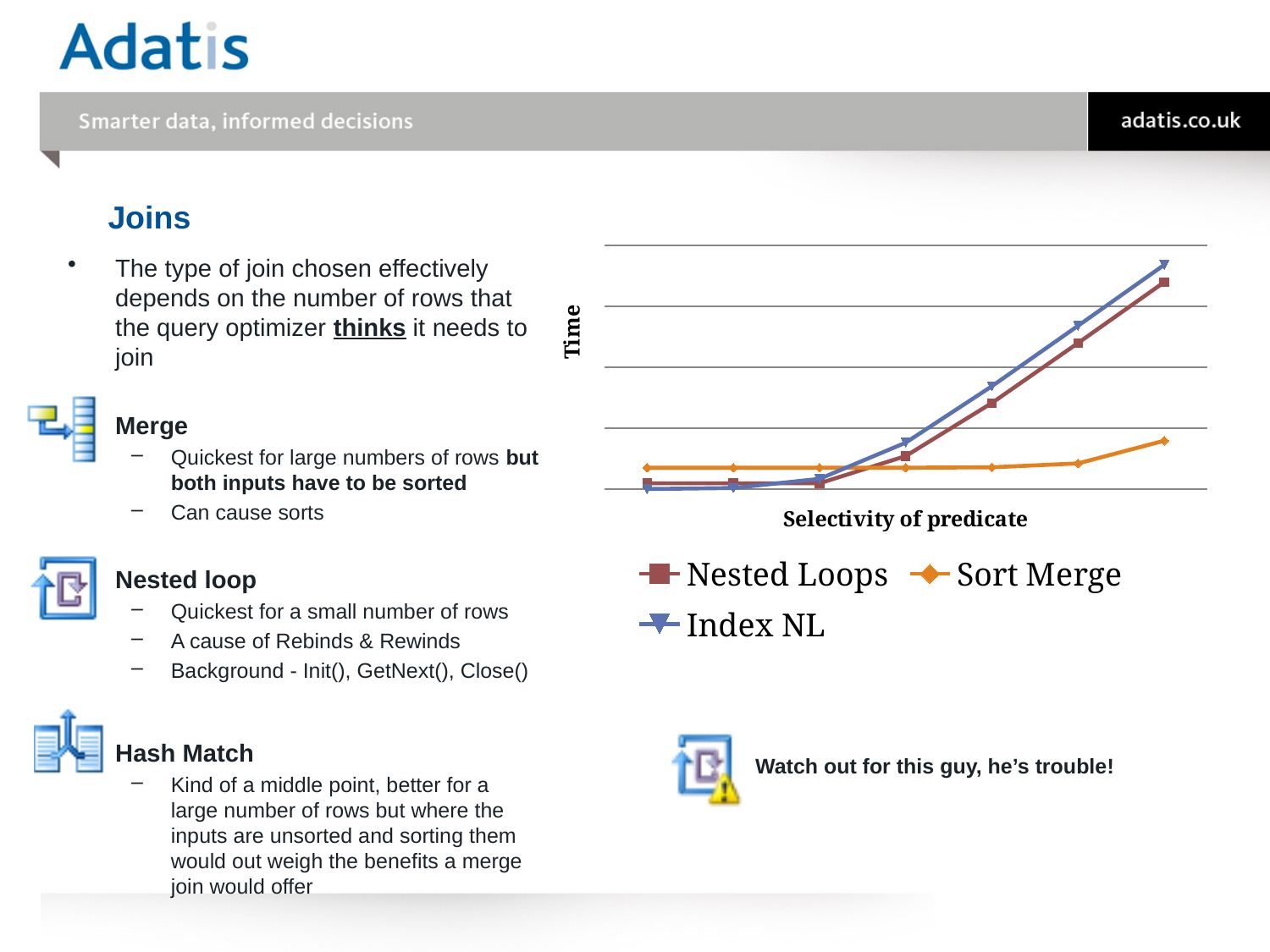
Which series has the lowest value at the right end of the chart? Sort Merge Does the Index NL series rise or fall as selectivity of predicate increases along the x axis? rise Which series stays nearly flat across most of the x axis? Sort Merge What are the names of the series listed in the chart's legend? Nested Loops, Sort Merge, Index NL What kind of chart is shown on the slide? line chart At the rightmost point, which is larger: the Nested Loops value or the Sort Merge value? Nested Loops What is the title of the chart's x axis? Selectivity of predicate How many series does the chart's legend list? 3 How many data points are plotted for the Nested Loops series? 7 Does the Nested Loops series rise or fall along the x axis? rise Which series reaches the highest value at the right end of the chart? Index NL At the rightmost point, which is larger: the Index NL value or the Nested Loops value? Index NL